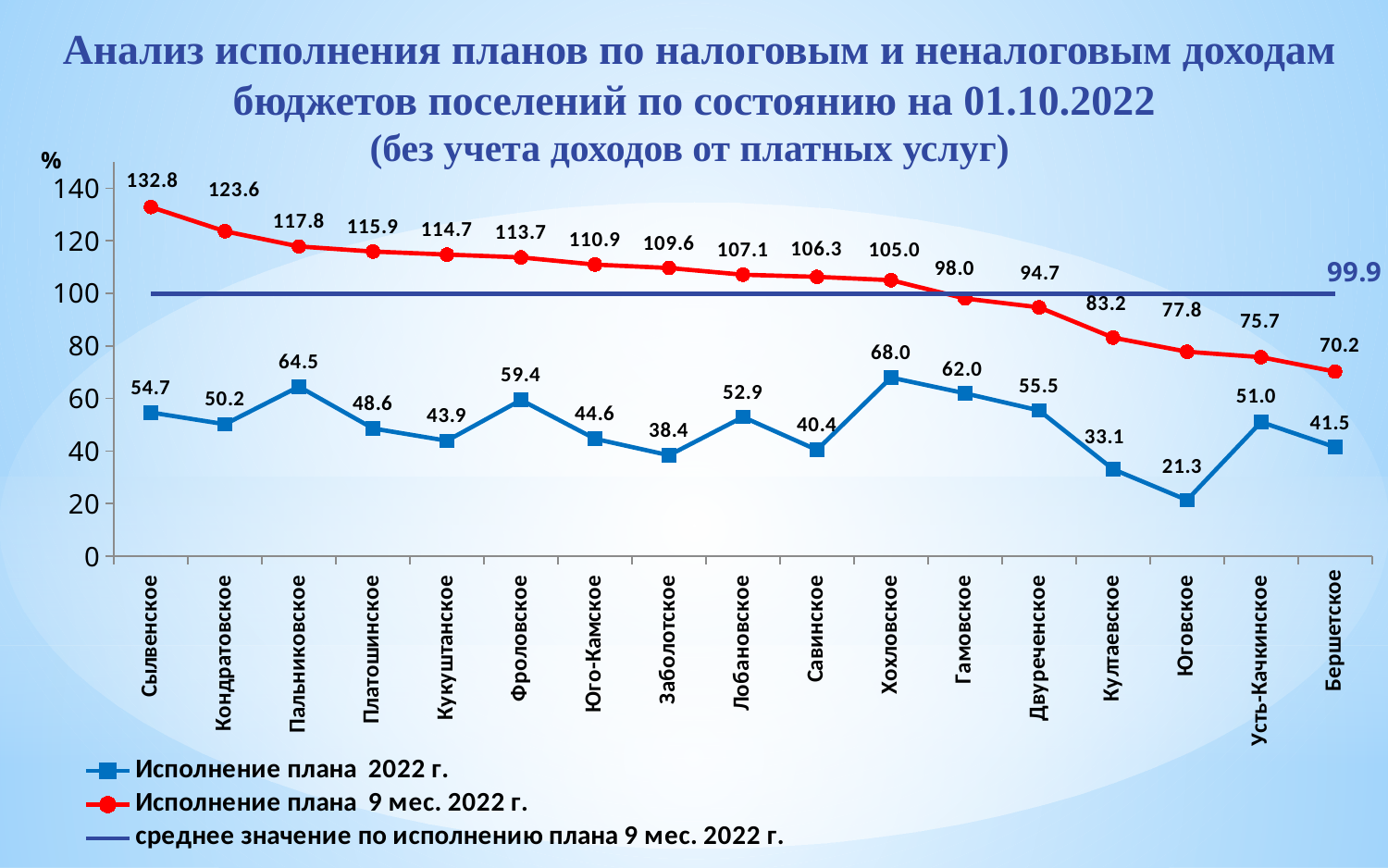
What is the value of the 'Исполнение плана 2022 г.' series for Юговское? 21.3 Which is larger: the 'Исполнение плана 2022 г.' value for Пальниковское or for Фроловское? Пальниковское What is the difference between the 'Исполнение плана 9 мес. 2022 г.' and 'Исполнение плана 2022 г.' values for Гамовское? 36.0 What kind of chart is shown on the slide? Line chart Which settlement has the highest value in the 'Исполнение плана 2022 г.' series? Хохловское What is the value of the 'среднее значение по исполнению плана 9 мес. 2022 г.' line? 99.9 How many settlements are shown on the x axis? 17 What is the value of the 'Исполнение плана 2022 г.' series for Хохловское? 68.0 How many series does the legend list? 3 Do the values of the 'Исполнение плана 9 мес. 2022 г.' series rise or fall from left to right along the x axis? Fall What is the value of the 'Исполнение плана 9 мес. 2022 г.' series for Сылвенское? 132.8 Which settlement has the lowest value in the 'Исполнение плана 9 мес. 2022 г.' series? Бершетское